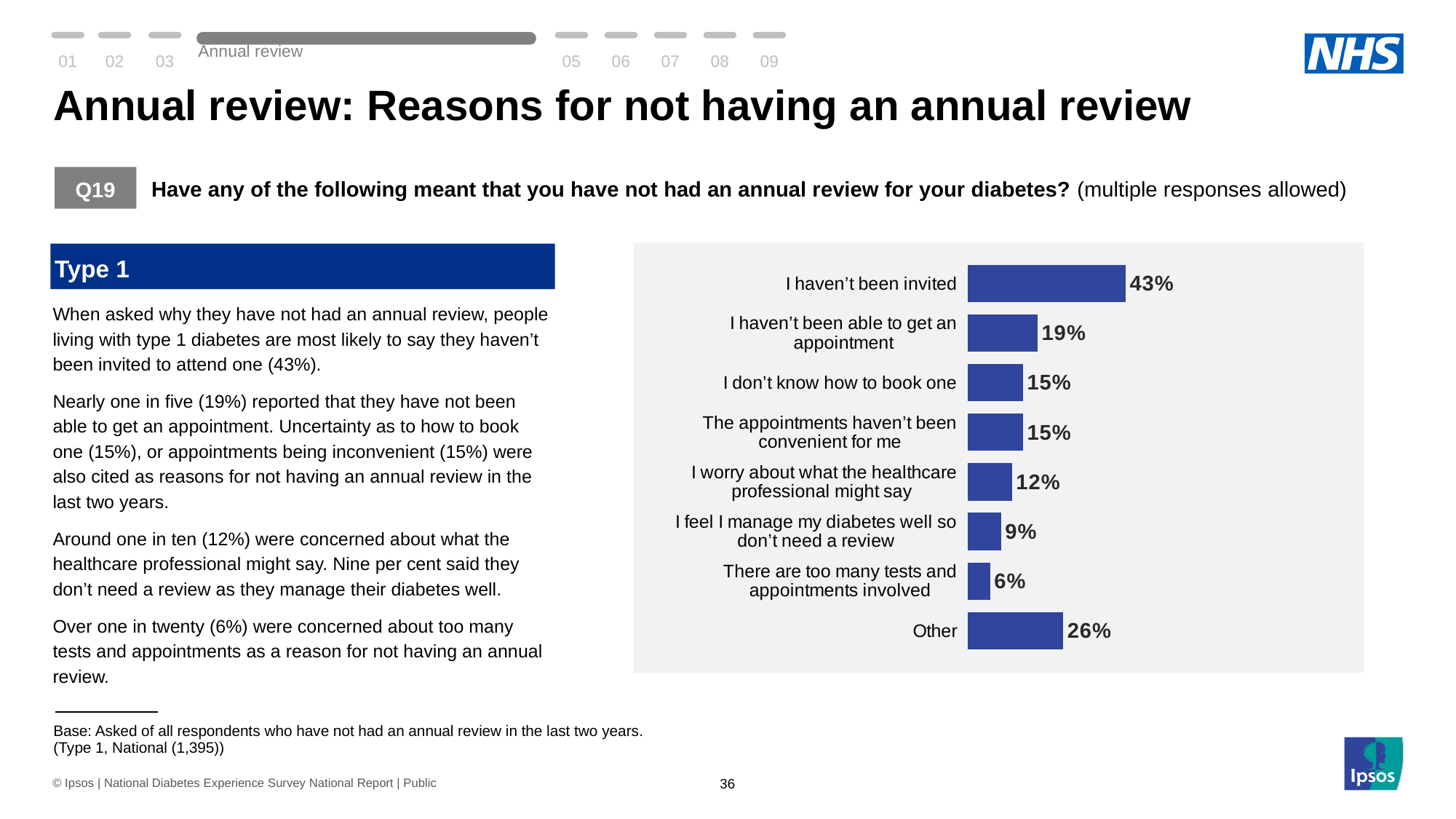
What is the difference between "I feel I manage my diabetes well so don't need a review" and "There are too many tests and appointments involved"? 3 percentage points What is the value for "Other"? 26% What percentage said "There are too many tests and appointments involved"? 6% Which reason has the highest percentage? I haven't been invited What kind of chart is shown on the slide? Bar chart Which reason has the lowest percentage? There are too many tests and appointments involved Which diabetes type does the chart on the slide refer to? Type 1 How many categories are shown in the chart? 8 What percentage of respondents said "I haven't been invited"? 43% Which is larger: "Other" or "I worry about what the healthcare professional might say"? Other What is the value for "I haven't been able to get an appointment"? 19% What is the difference between "I haven't been invited" and "I haven't been able to get an appointment"? 24 percentage points